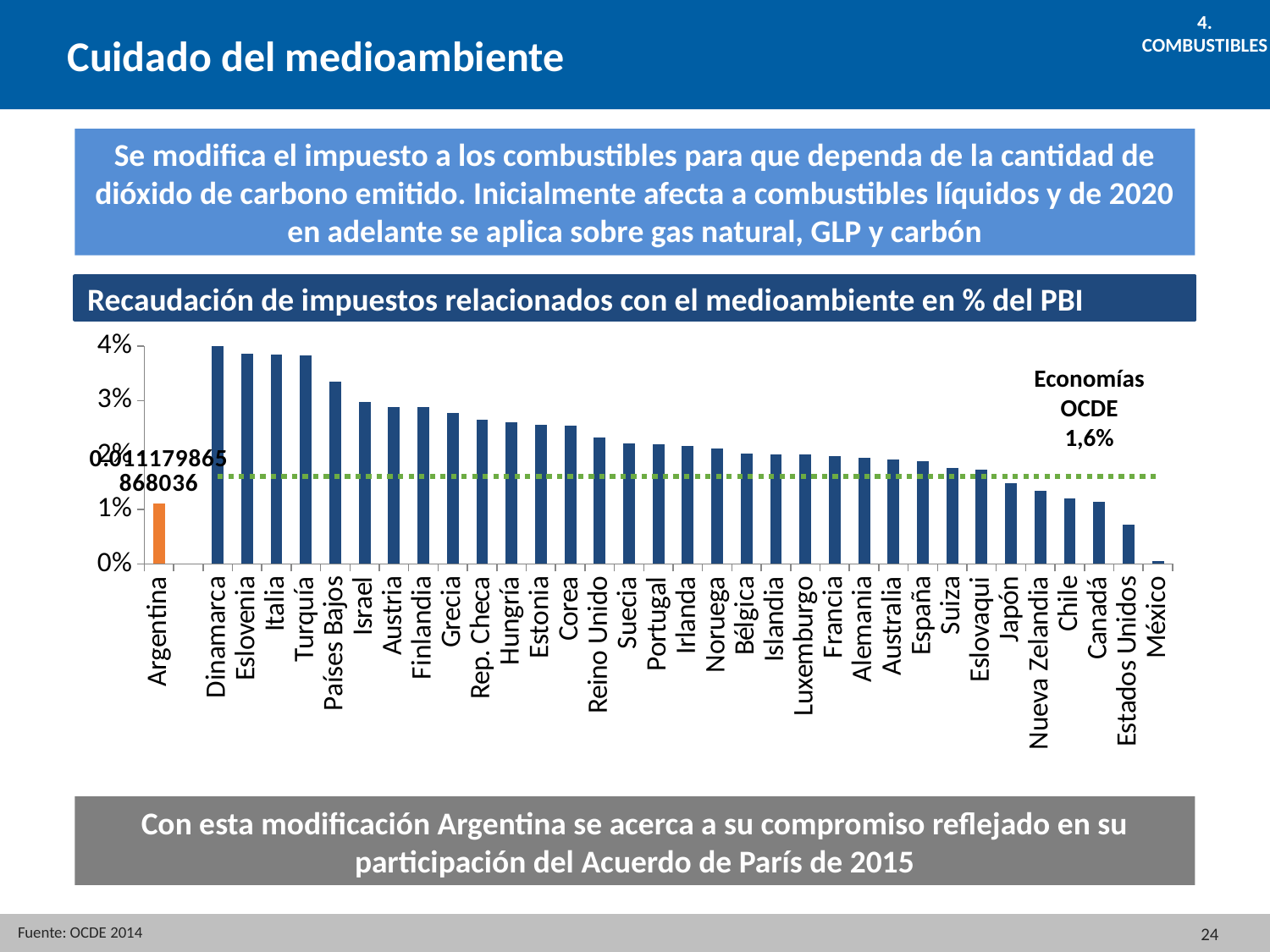
Is the value for Japón greater or less than 2%? less Which is larger, the value for Argentina or the value for Dinamarca? Dinamarca Which is larger, the value for Canadá or the value for Estados Unidos? Canadá Which country has the lowest value in the chart? México Is the value for Estados Unidos greater or less than 1%? less What is the title of the chart? Recaudación de impuestos relacionados con el medioambiente en % del PBI Which country has the highest value in the chart? Dinamarca Is the value for Dinamarca greater or less than 3%? greater What kind of chart is shown on the slide? bar chart What value is given for the 'Economías OCDE' reference line? 1,6% Do the values for the OECD countries rise or fall from left to right along the x axis? fall